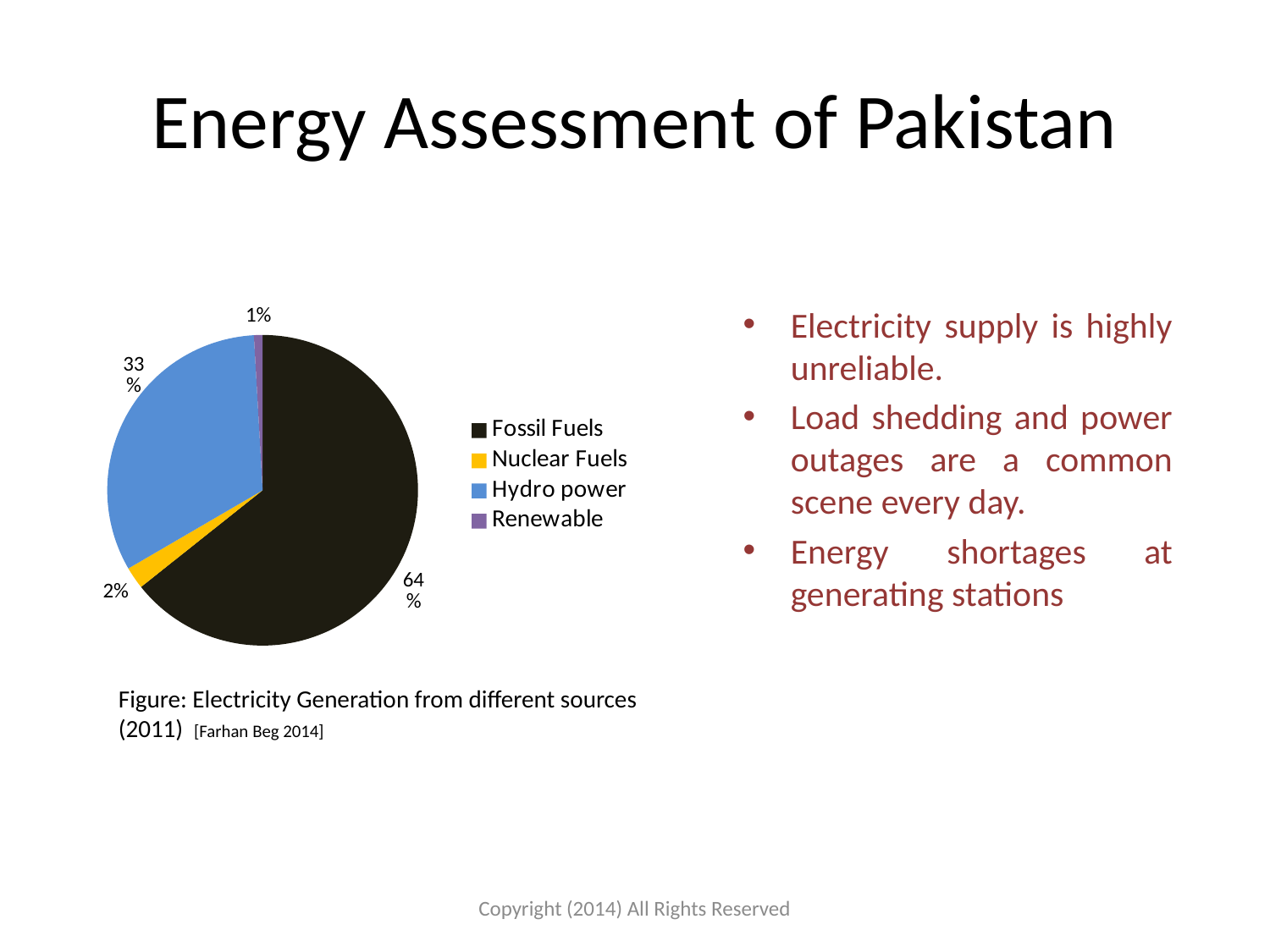
Which source has the largest share of electricity generation? Fossil Fuels What share of electricity generation comes from Fossil Fuels? 64% What is the caption of the figure below the pie chart? Figure: Electricity Generation from different sources (2011) What share of electricity generation comes from Renewable? 1% Which source has the smallest share of electricity generation? Renewable How many sources are shown in the pie chart? 4 What kind of chart is shown on the slide? pie chart What colour represents Hydro power in the pie chart? blue Which has a larger share, Nuclear Fuels or Hydro power? Hydro power What share of electricity generation comes from Nuclear Fuels? 2% What is the difference in percentage points between the Fossil Fuels share and the Hydro power share? 31